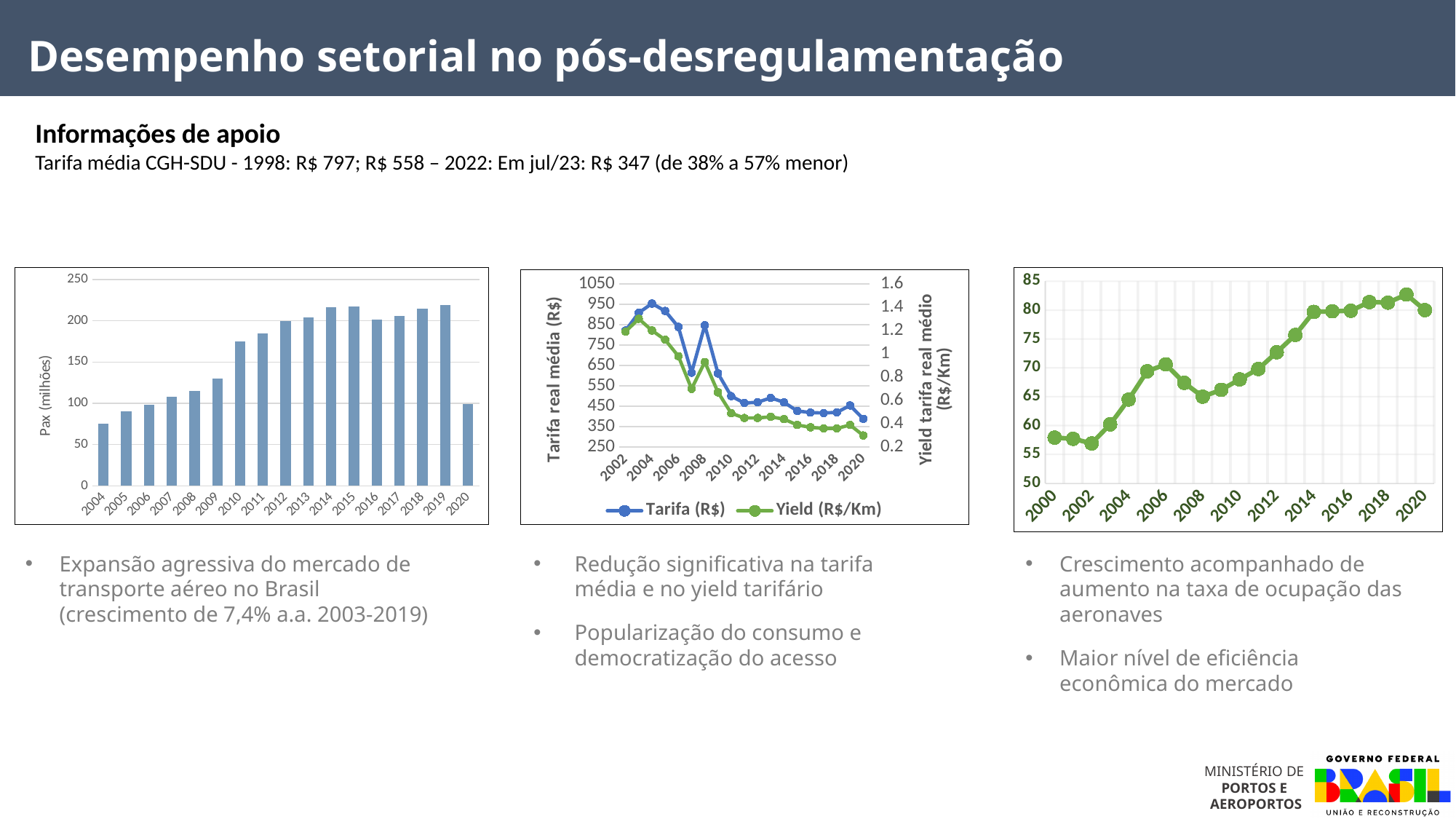
In the right chart (2000–2020), which year has the highest value? 2019 In the left chart (Pax (milhões)), which year has the lowest value? 2004 In the middle chart (Tarifa real média), in which year does the Tarifa (R$) series reach its highest value? 2004 In the left chart (Pax (milhões)), is the value for 2010 greater or less than 150? greater In the right chart (2000–2020), is the value for 2000 greater or less than 60? less In the left chart (Pax (milhões)), how many years are shown on the x axis? 17 In the left chart (Pax (milhões)), is the value for 2020 greater or less than 150? less What kind of chart is the left chart (Pax (milhões))? bar chart In the middle chart (Tarifa real média), how many series does the legend list? 2 In the middle chart (Tarifa real média), what are the two legend entries? Tarifa (R$) and Yield (R$/Km) In the left chart (Pax (milhões)), which is larger, the value for 2020 or the value for 2004? 2020